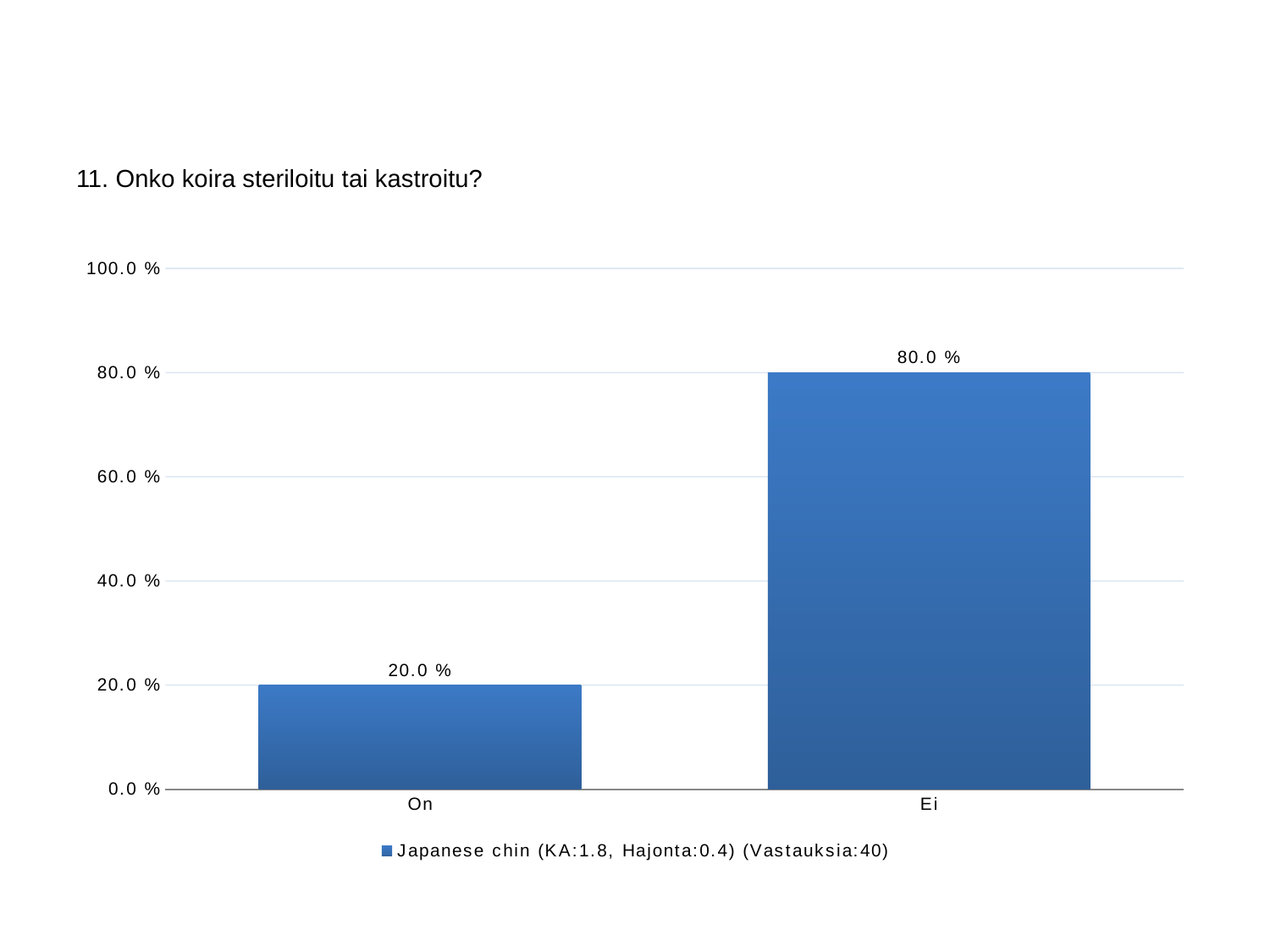
What is the value for "On"? 20.0 % What is the value for "Ei"? 80.0 % How many series does the legend list? 1 Which category has the highest value? Ei Is the value for "On" greater or less than 40.0 %? less Is the value for "Ei" greater or less than 60.0 %? greater What is the difference between the values for "Ei" and "On"? 60.0 % Which is larger, the value for "On" or the value for "Ei"? Ei What is the title of the chart? 11. Onko koira steriloitu tai kastroitu? Which category has the lowest value? On How many categories are shown on the x axis? 2 What kind of chart is shown on the slide? bar chart